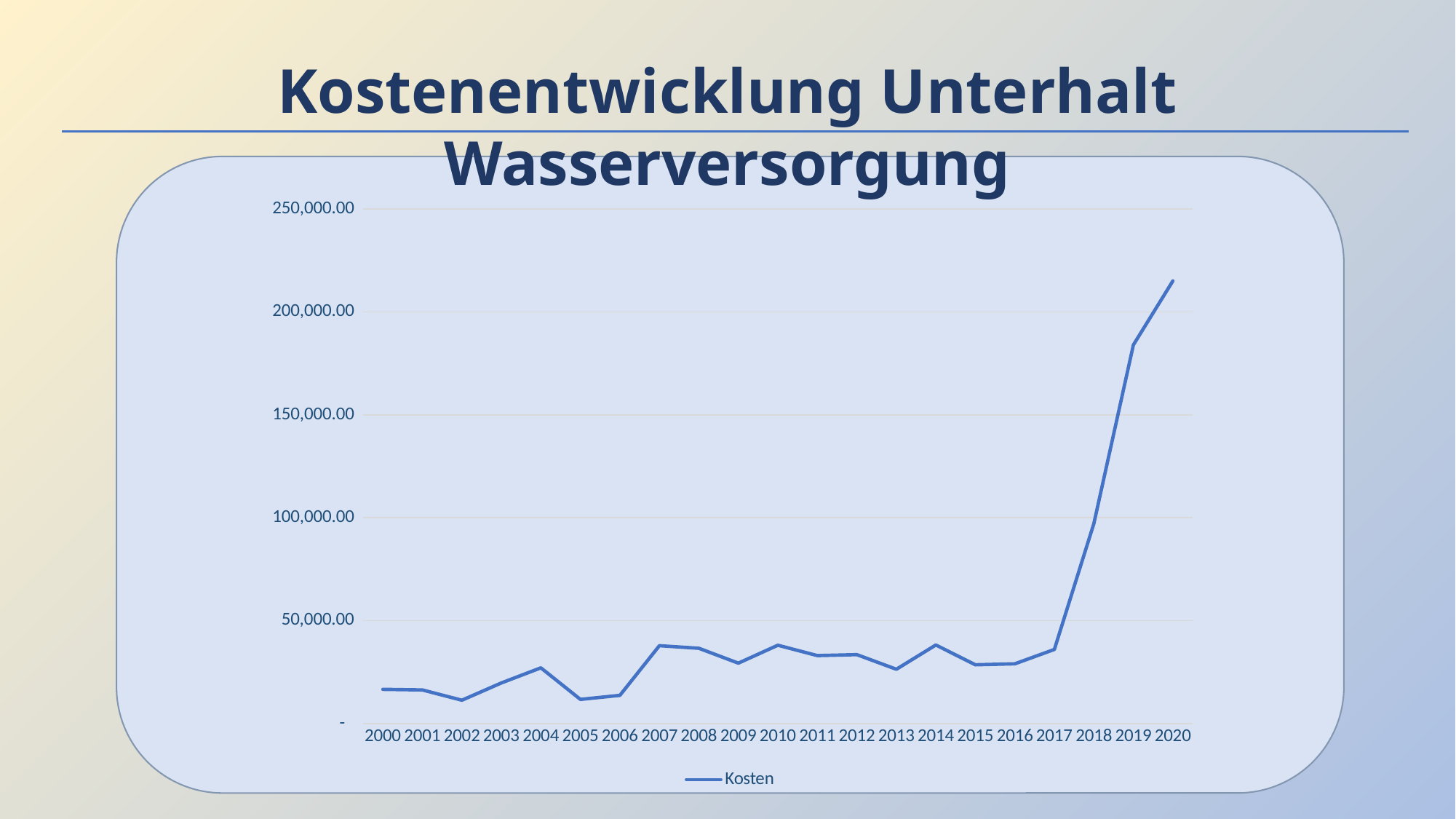
Is the value for 2019 greater or less than 150,000.00? greater Is the value for 2018 greater or less than 50,000.00? greater Is the value for 2020 greater or less than 200,000.00? greater Which is larger, the value for 2000 or the value for 2020? 2020 Do the values rise or fall from 2017 to 2020? rise Which is larger, the value for 2004 or the value for 2005? 2004 What is the name of the series shown in the legend? Kosten How many years are plotted along the x axis? 21 How many series does the legend list? 1 Which year has the highest value for Kosten? 2020 What kind of chart is shown on the slide? line chart